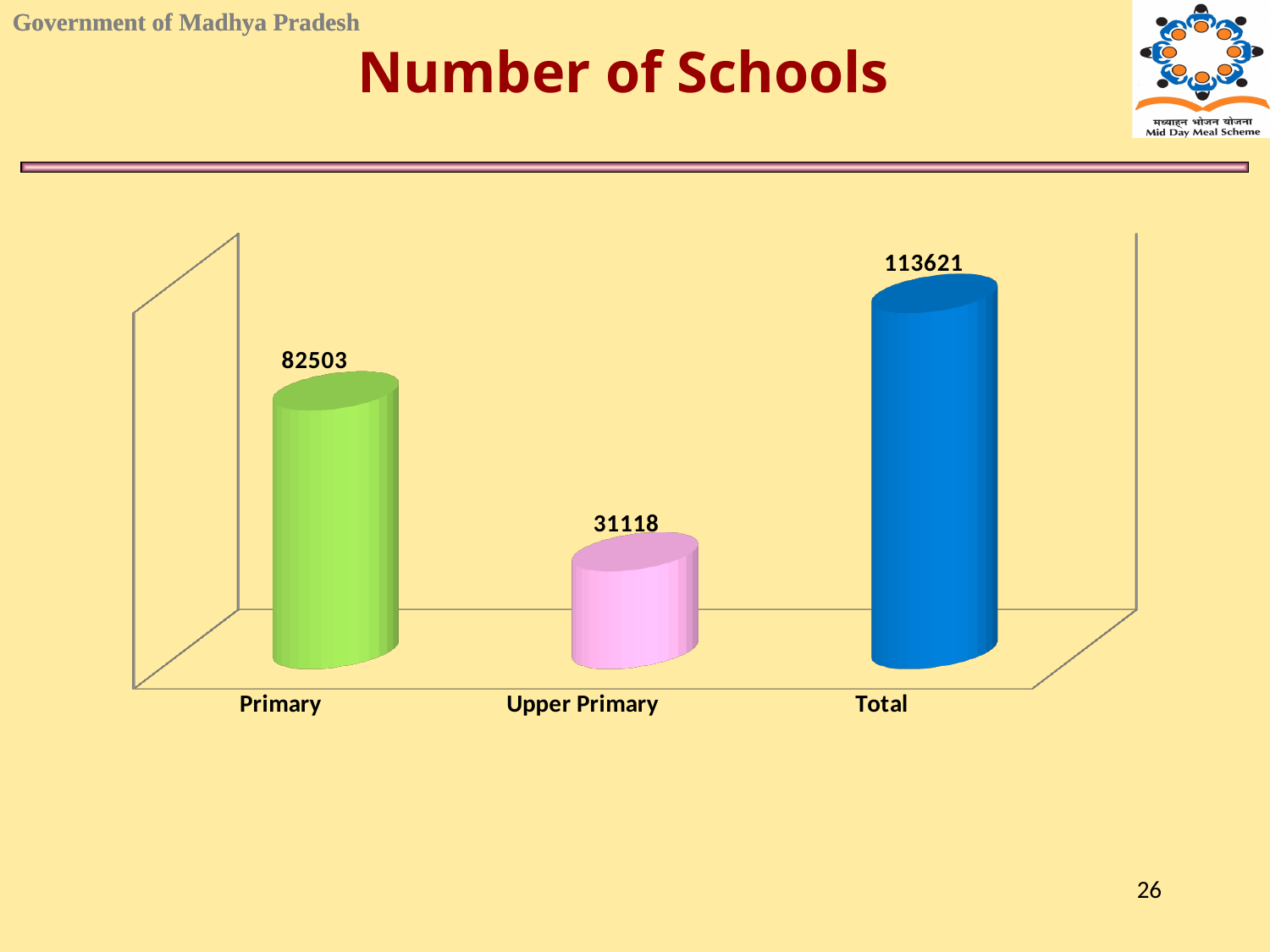
Which category has the highest value on the chart? Total How many categories are shown on the x axis of the chart? 3 What is the number of Upper Primary schools shown on the chart? 31118 What is the difference between the Total and Primary values? 31118 Which is larger, the value for Primary or the value for Upper Primary? Primary What value is shown for Total on the chart? 113621 What is the difference between the Primary and Upper Primary values? 51385 What is the title of the chart on the slide? Number of Schools What is the number of Primary schools shown on the chart? 82503 Which category has the lowest value on the chart? Upper Primary What kind of chart is shown on the slide? Bar chart What colour is the bar for Total? Blue